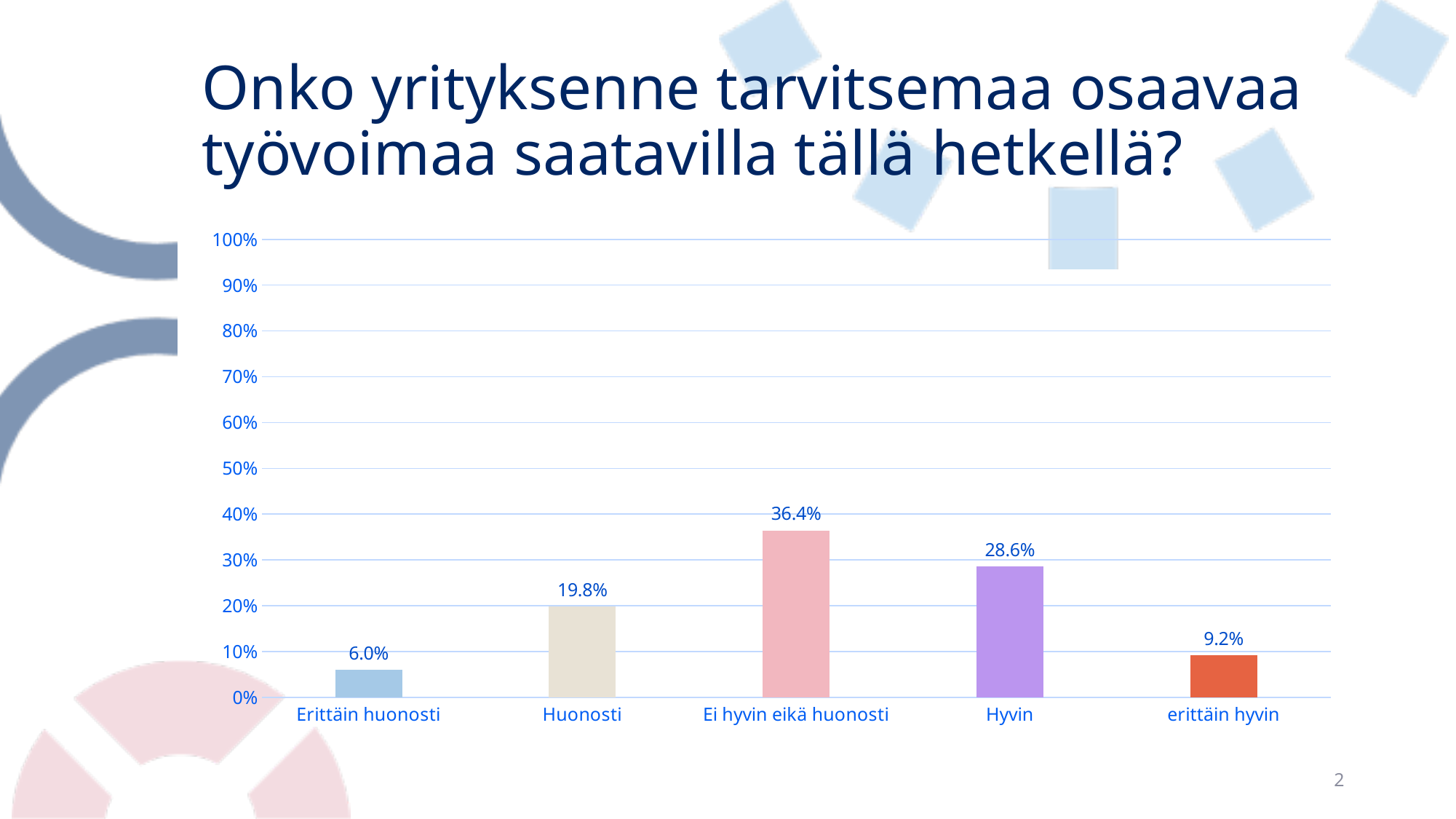
What is the value for "Ei hyvin eikä huonosti"? 36.4% Which is larger, the value for "Huonosti" or the value for "erittäin hyvin"? Huonosti Which category has the lowest value? Erittäin huonosti Which category has the highest value? Ei hyvin eikä huonosti How many categories are shown on the x axis? 5 What is the value for "erittäin hyvin"? 9.2% Is the value for "Huonosti" greater or less than 30%? less What is the difference between the values for "Ei hyvin eikä huonosti" and "Hyvin"? 7.8% What is the value for "Erittäin huonosti"? 6.0% What is the title of the slide? Onko yrityksenne tarvitsemaa osaavaa työvoimaa saatavilla tällä hetkellä? What kind of chart is shown on the slide? bar chart What is the value for "Hyvin"? 28.6%